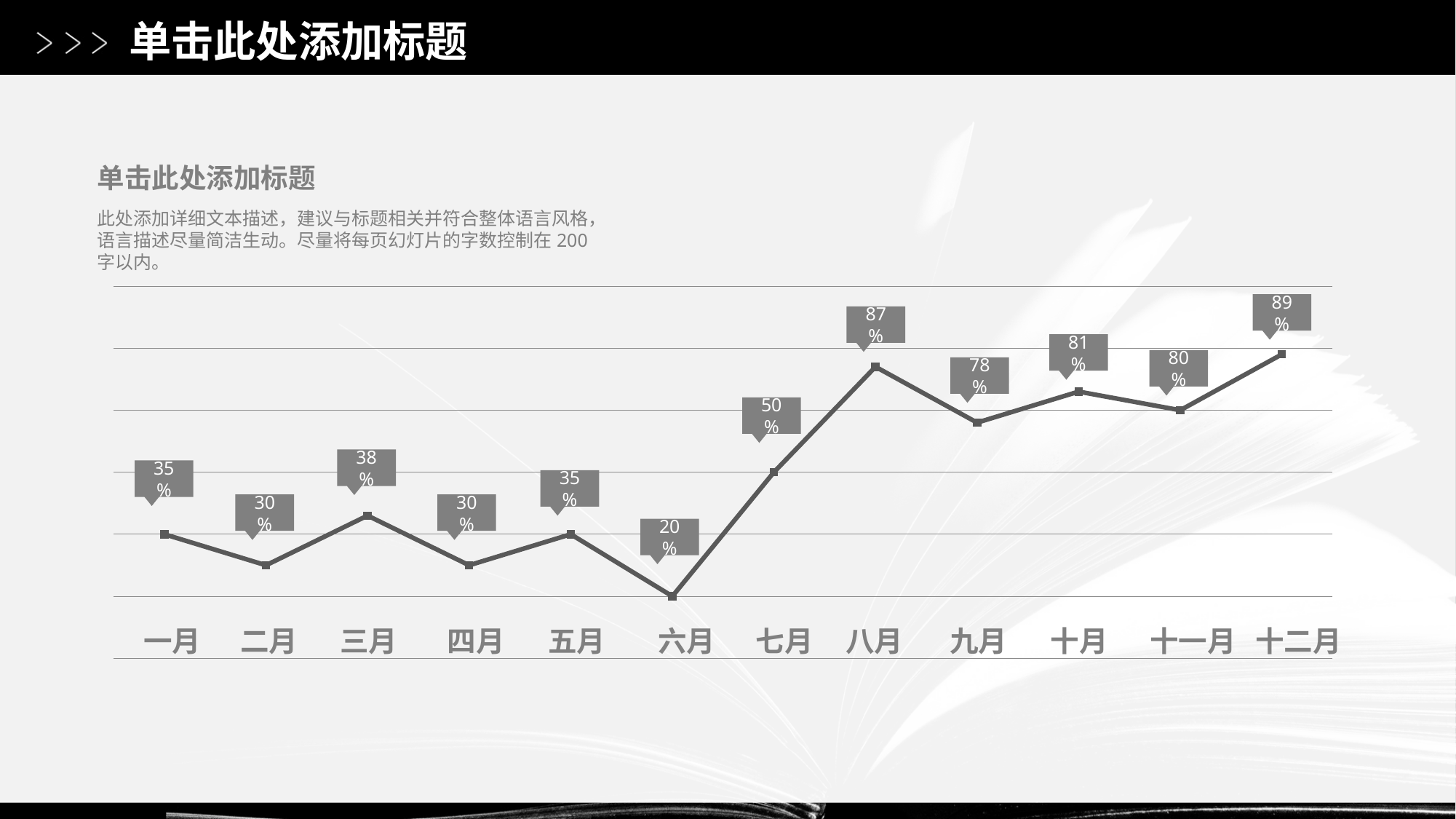
What kind of chart is shown on the slide? line chart What is the difference between the values for 八月 and 七月? 37% What is the value for 八月 (August)? 87% Does the value rise or fall from 七月 to 八月? rise What is the value for 三月 (March)? 38% How many months are plotted on the x axis? 12 Which is larger, the value for 一月 or the value for 二月? 一月 What is the value for 六月 (June)? 20% Which is larger, the value for 九月 or the value for 十月? 十月 What is the difference between the values for 十二月 and 一月? 54% Which month has the lowest value? 六月 Which month has the highest value? 十二月